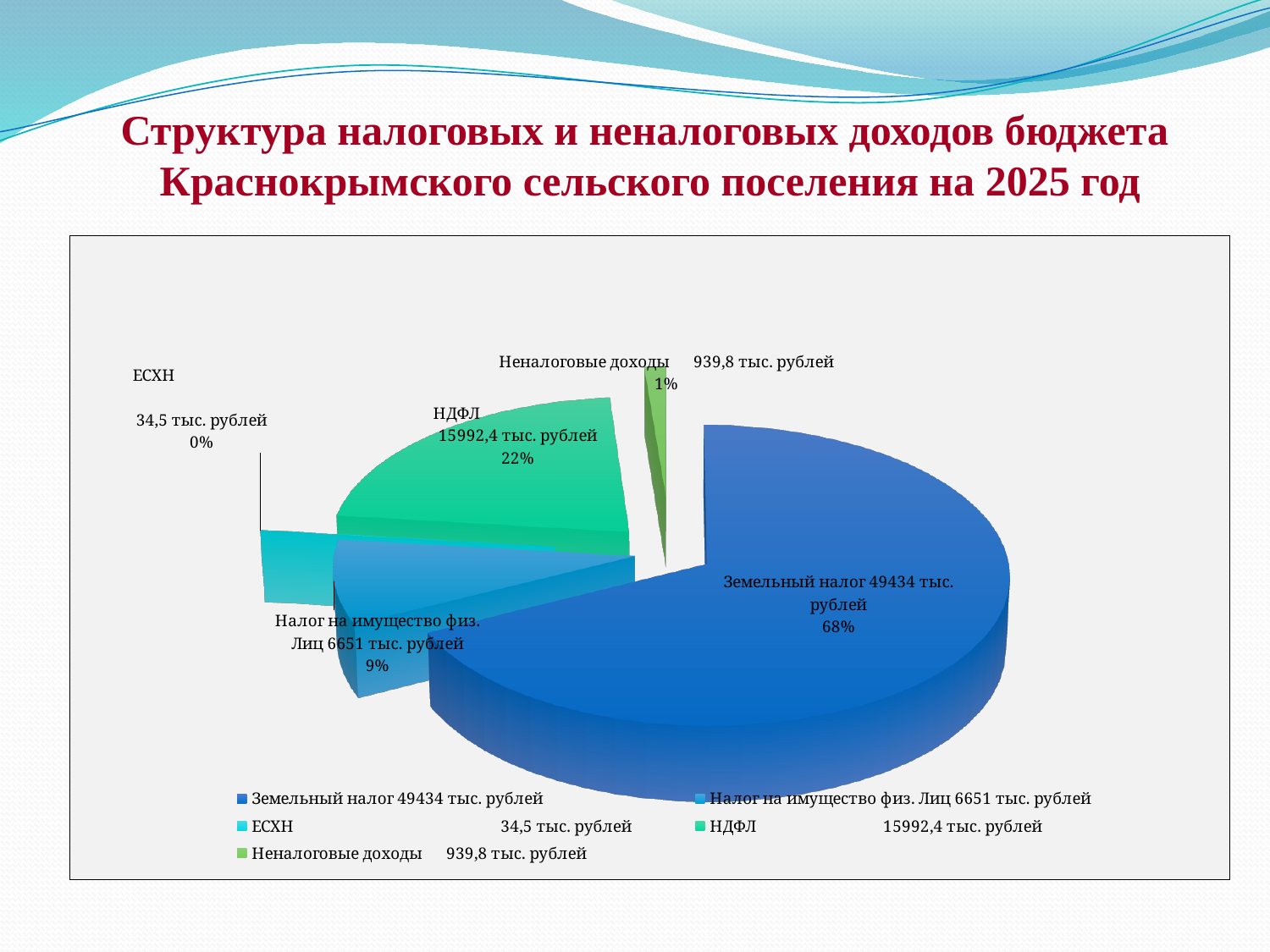
How many slices does the pie chart have? 5 Which is larger, the share for НДФЛ or the share for Налог на имущество физ. Лиц? НДФЛ What kind of chart is shown on the slide? pie chart What is the difference in percentage points between the share for Земельный налог and the share for НДФЛ? 46 What share of the pie does НДФЛ have? 22% What value is shown for Неналоговые доходы? 939,8 тыс. рублей What share of the pie does Земельный налог have? 68% What share of the pie does Неналоговые доходы have? 1% What value is shown for ЕСХН? 34,5 тыс. рублей Which category has the smallest slice of the pie? ЕСХН Which category has the largest slice of the pie? Земельный налог